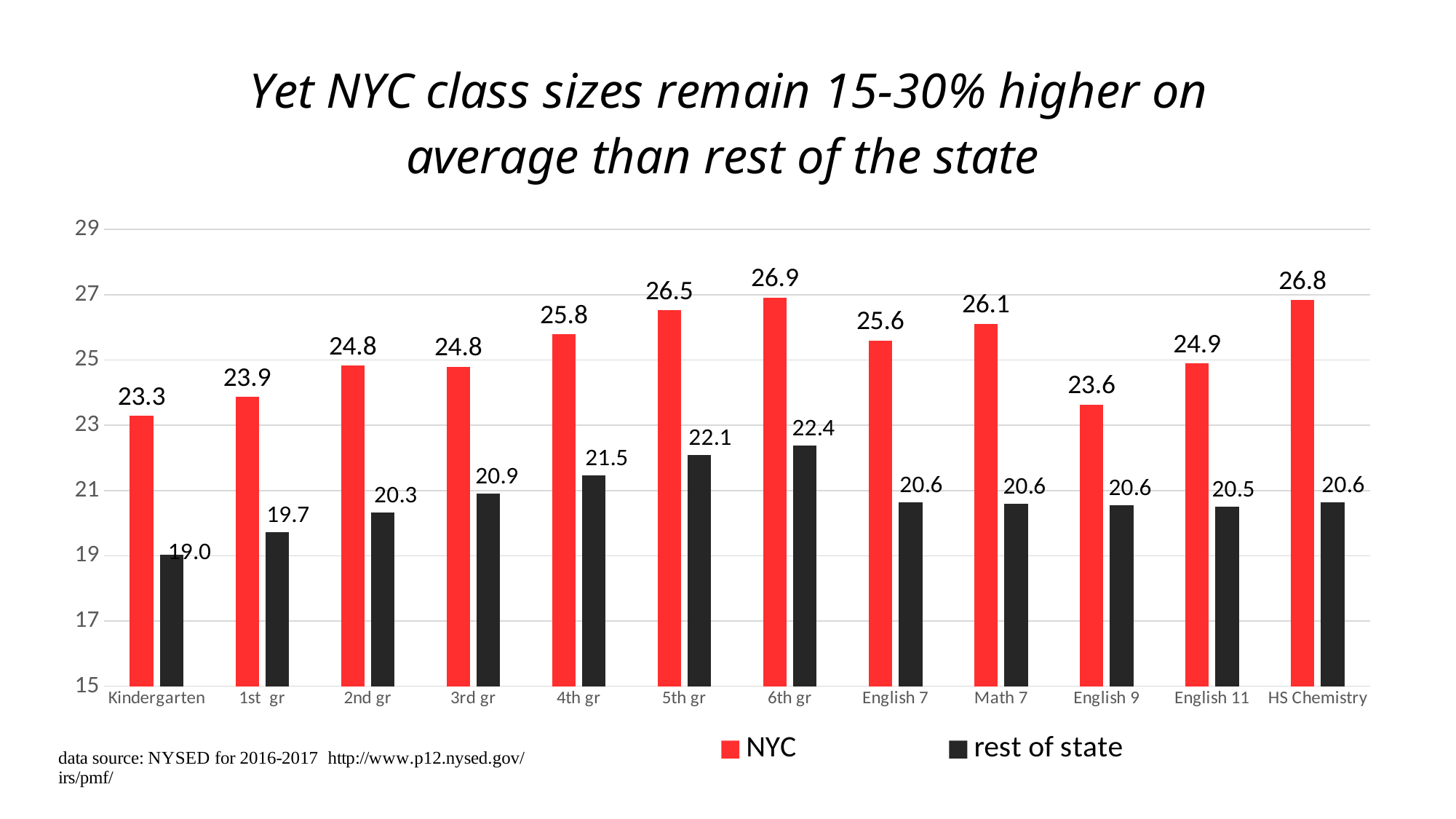
Which is larger, the NYC class size for 5th gr or for HS Chemistry? HS Chemistry What is the NYC class size for 6th gr? 26.9 What is the difference between the NYC and rest of state class sizes for 4th gr? 4.3 What is the rest of state class size for 6th gr? 22.4 How many series does the legend list? 2 Which category has the highest NYC class size? 6th gr Which category has the lowest rest of state class size? Kindergarten How many categories are shown on the x axis? 12 What is the rest of state class size for Kindergarten? 19.0 What kind of chart is shown on the slide? bar chart What is the NYC class size for English 9? 23.6 Which colour represents the NYC series in the chart? red